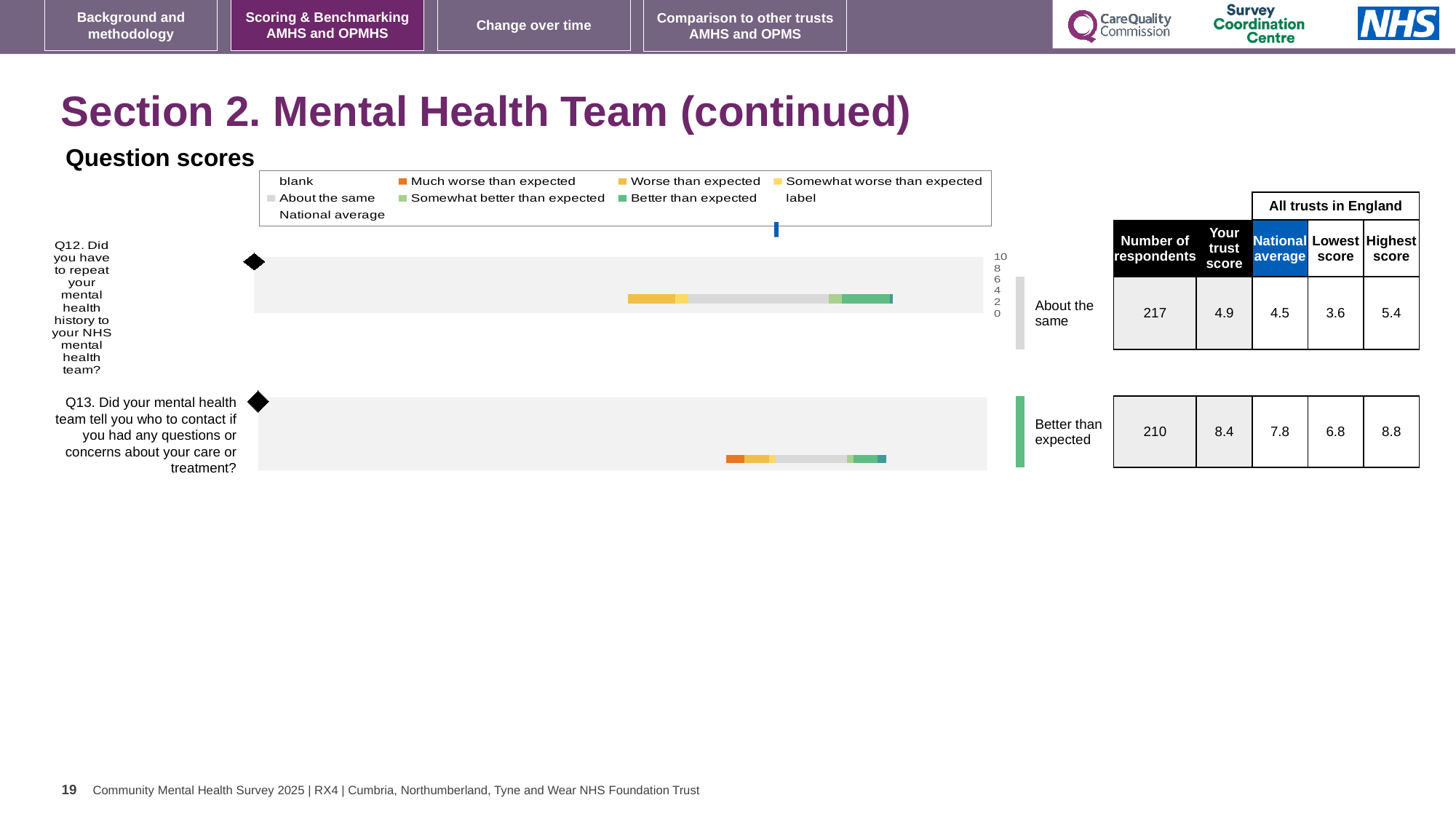
What is the difference between your trust score and the national average for Q13? 0.6 What is the difference between the highest and lowest scores for Q12? 1.8 What is the national average score for Q12? 4.5 How many entries does the legend of the question scores chart list? 9 What is the number of respondents for Q12? 217 What is the highest score among all trusts in England for Q13? 8.8 Which benchmark category is shown for Q13 (who to contact with questions or concerns)? Better than expected What is your trust score for Q13? 8.4 How many questions are plotted in the question scores chart? 2 Which question has the higher trust score, Q12 or Q13? Q13 What kind of chart is used to show the question scores on this slide? bar chart Which benchmark category is shown for Q12 (repeating mental health history)? About the same